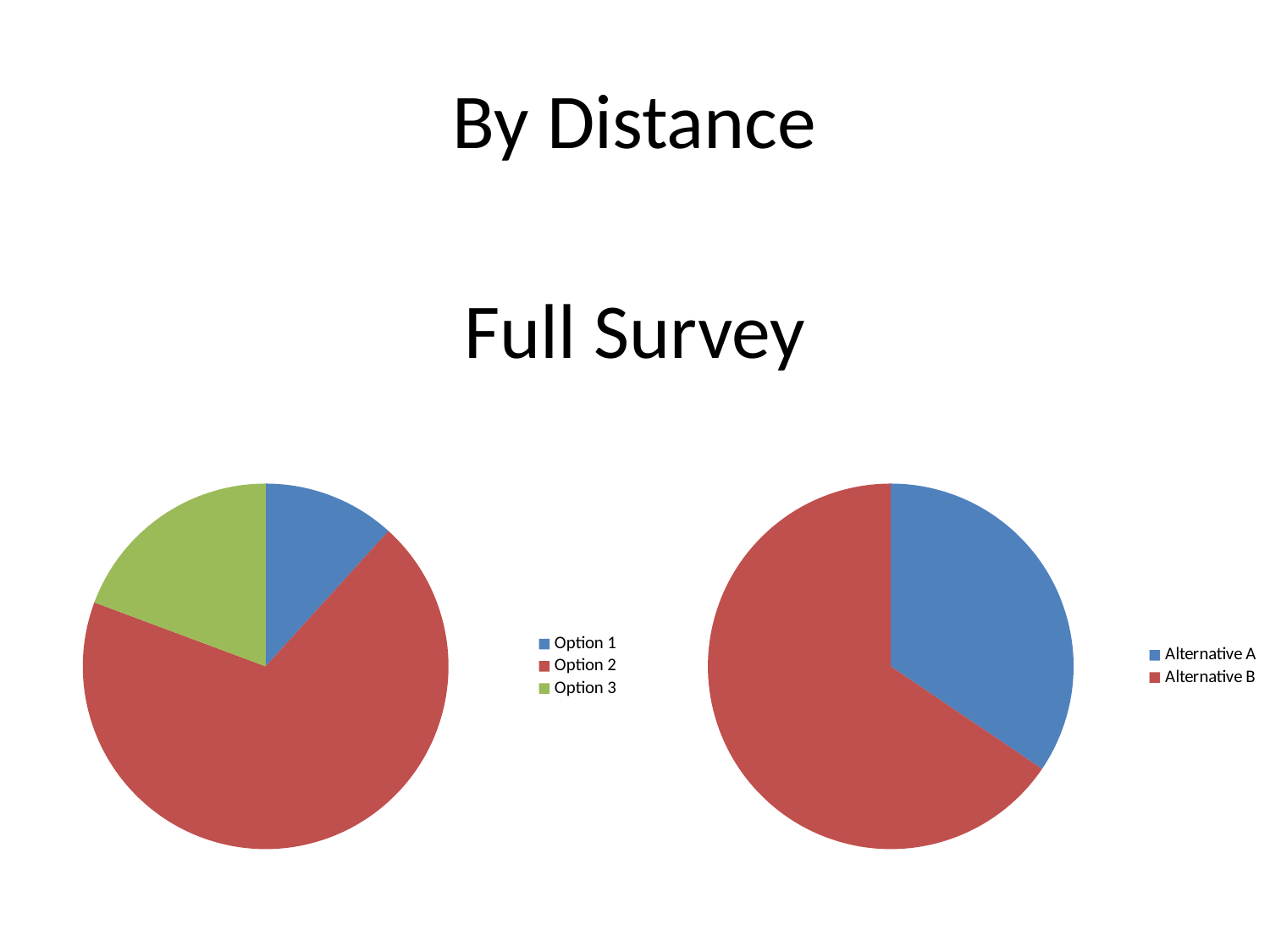
In the left pie chart, which slice is larger, Option 2 or Option 3? Option 2 In the right pie chart, which category has the smallest slice? Alternative A In the left pie chart, which slice is larger, Option 1 or Option 3? Option 3 How many entries does the legend of the right pie chart list? 2 How many slices does the right pie chart have? 2 In the right pie chart, which category has the largest slice? Alternative B How many slices does the left pie chart have? 3 In the left pie chart, what colour is the Option 3 slice? green In the left pie chart, which category has the largest slice? Option 2 In the left pie chart, which category has the smallest slice? Option 1 What kind of chart is the chart on the left of the slide? pie chart What kind of chart is the chart on the right of the slide? pie chart